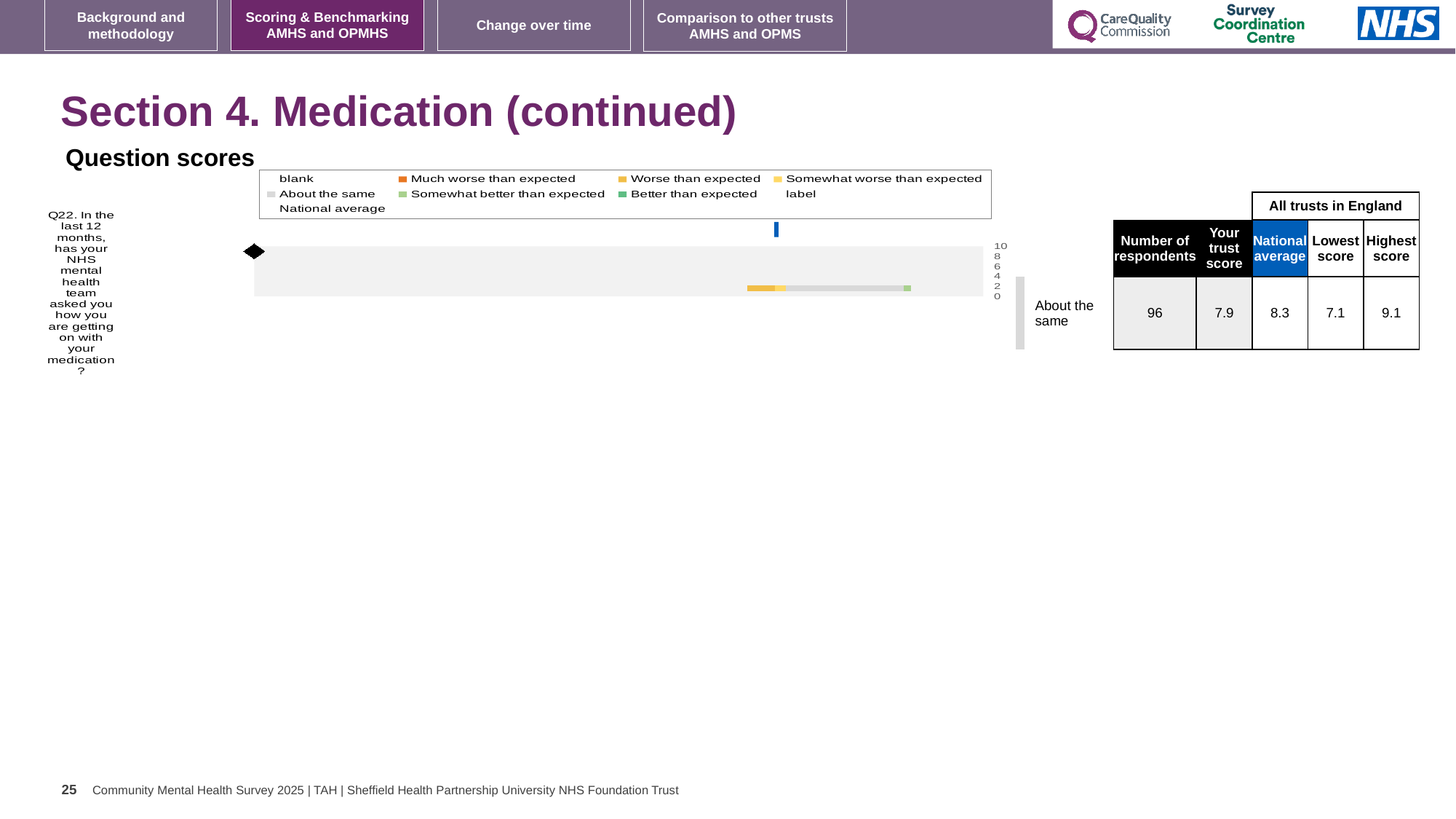
How many respondents answered Q22 according to the table beside the chart? 96 How many questions are plotted in the 'Question scores' chart? 1 Which question is plotted in the 'Question scores' chart? Q22. In the last 12 months, has your NHS mental health team asked you how you are getting on with your medication? What is the difference between the national average and the trust score for Q22? 0.4 How many entries does the legend of the 'Question scores' chart list? 9 Which is larger for Q22, the trust score or the national average? National average What is the lowest score among all trusts in England for Q22? 7.1 What is the highest score among all trusts in England for Q22? 9.1 What is the national average for Q22 shown in the table beside the chart? 8.3 What kind of chart is shown under 'Question scores'? Bar chart What is the trust score for Q22 shown in the table beside the chart? 7.9 What benchmark category is shown for Q22 next to the chart? About the same